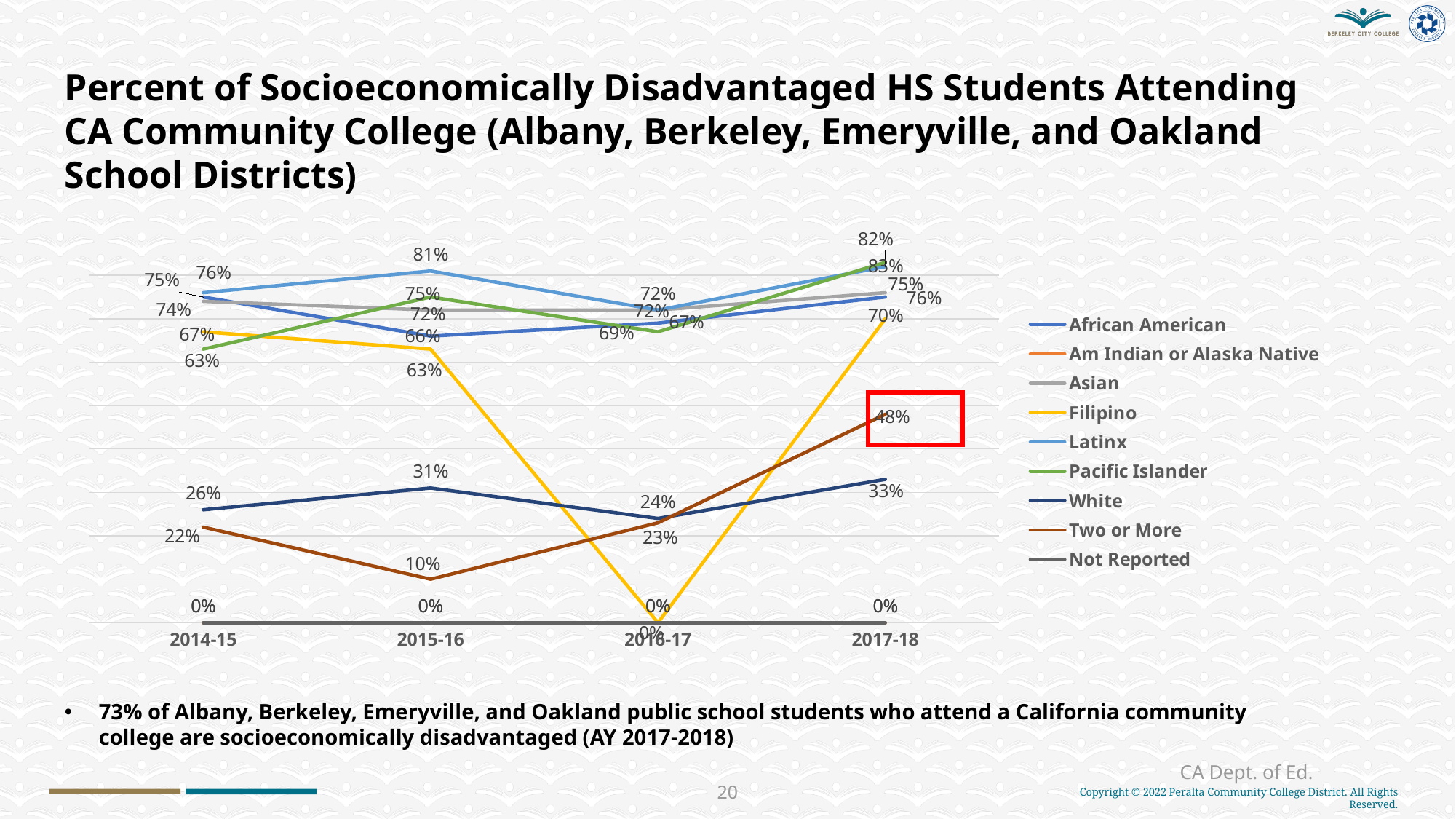
What is the value for Filipino in 2017-18? 70% How many series does the legend list? 9 How many academic years are shown on the x axis? 4 What is the value for African American in 2015-16? 66% What is the value for White in 2015-16? 31% What is the value for Latinx in 2015-16? 81% What is the value for Filipino in 2016-17? 0% In 2017-18, which is larger: the value for White or the value for Two or More? Two or More In which year is the Two or More series lowest? 2015-16 By how many percentage points did the Two or More value change from 2016-17 to 2017-18? 25 percentage points What kind of chart is shown on the slide? Line chart What is the value for Two or More in 2017-18? 48%